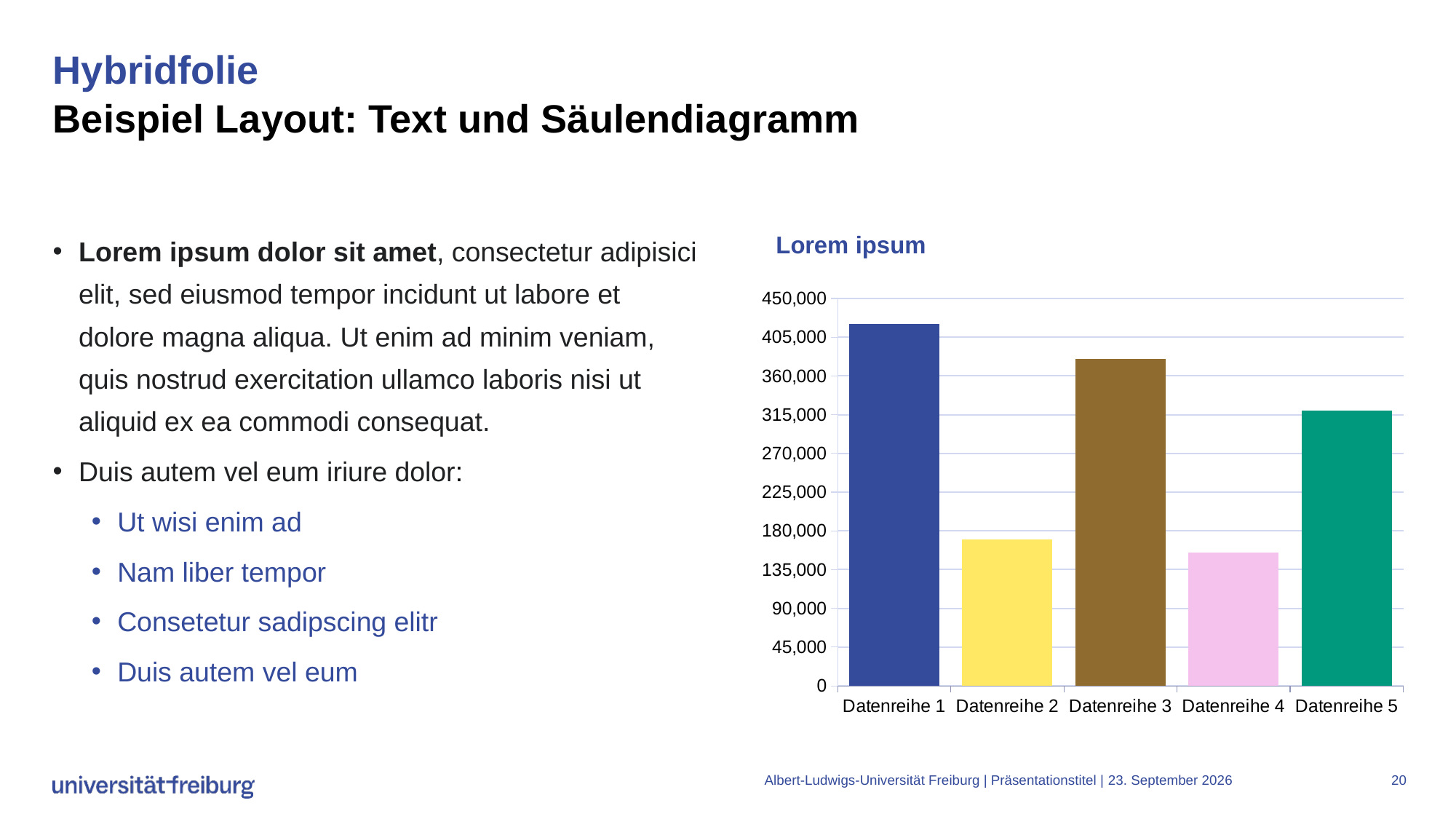
Is the value for Datenreihe 3 greater or less than 360,000? greater Which category has the highest value in the chart? Datenreihe 1 Is the value for Datenreihe 5 greater or less than 270,000? greater Is the value for Datenreihe 2 greater or less than 180,000? less Which is larger, the value for Datenreihe 2 or the value for Datenreihe 4? Datenreihe 2 Which is larger, the value for Datenreihe 3 or the value for Datenreihe 5? Datenreihe 3 What kind of chart is shown on the slide? bar chart What is the title of the chart? Lorem ipsum Which category has the lowest value in the chart? Datenreihe 4 How many categories are plotted in the chart? 5 What colour is the bar for Datenreihe 5? green